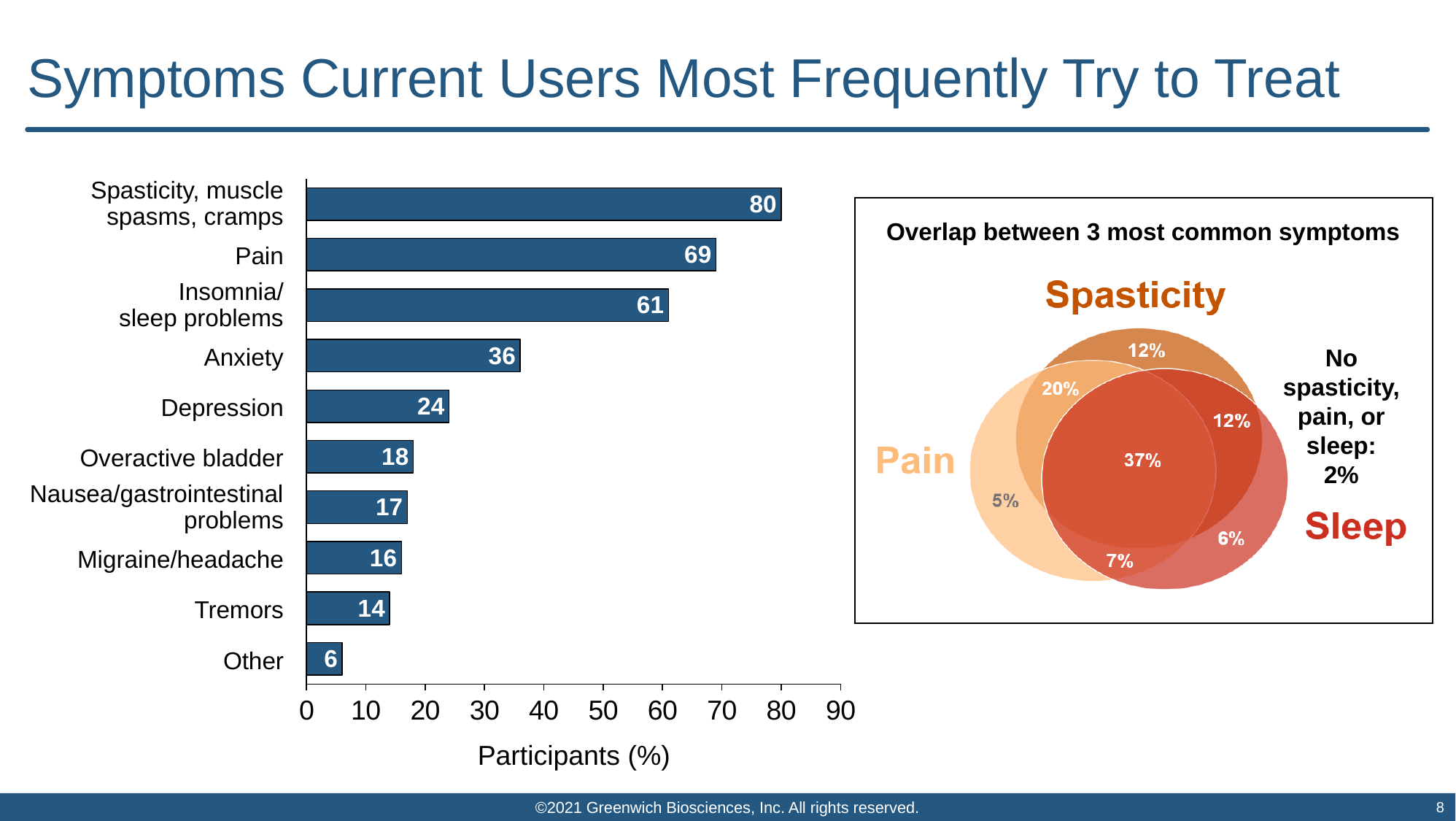
In the bar chart, what is the difference between the values for Pain and Insomnia/sleep problems? 8 In the Venn diagram, what percentage of participants have all three of spasticity, pain, and sleep problems? 37% In the bar chart, which is larger: Overactive bladder or Migraine/headache? Overactive bladder What type of chart is used on the left side of the slide? Bar chart In the bar chart, which symptom has the highest percentage of participants? Spasticity, muscle spasms, cramps In the bar chart, what percentage of participants try to treat Pain? 69 In the bar chart, what is the value for Anxiety? 36 How many symptom categories are shown in the bar chart? 10 What is the axis label on the horizontal axis of the bar chart? Participants (%) In the Venn diagram, what percentage have no spasticity, pain, or sleep problems? 2% In the bar chart, which category has the lowest value? Other In the bar chart, what is the value for Tremors? 14